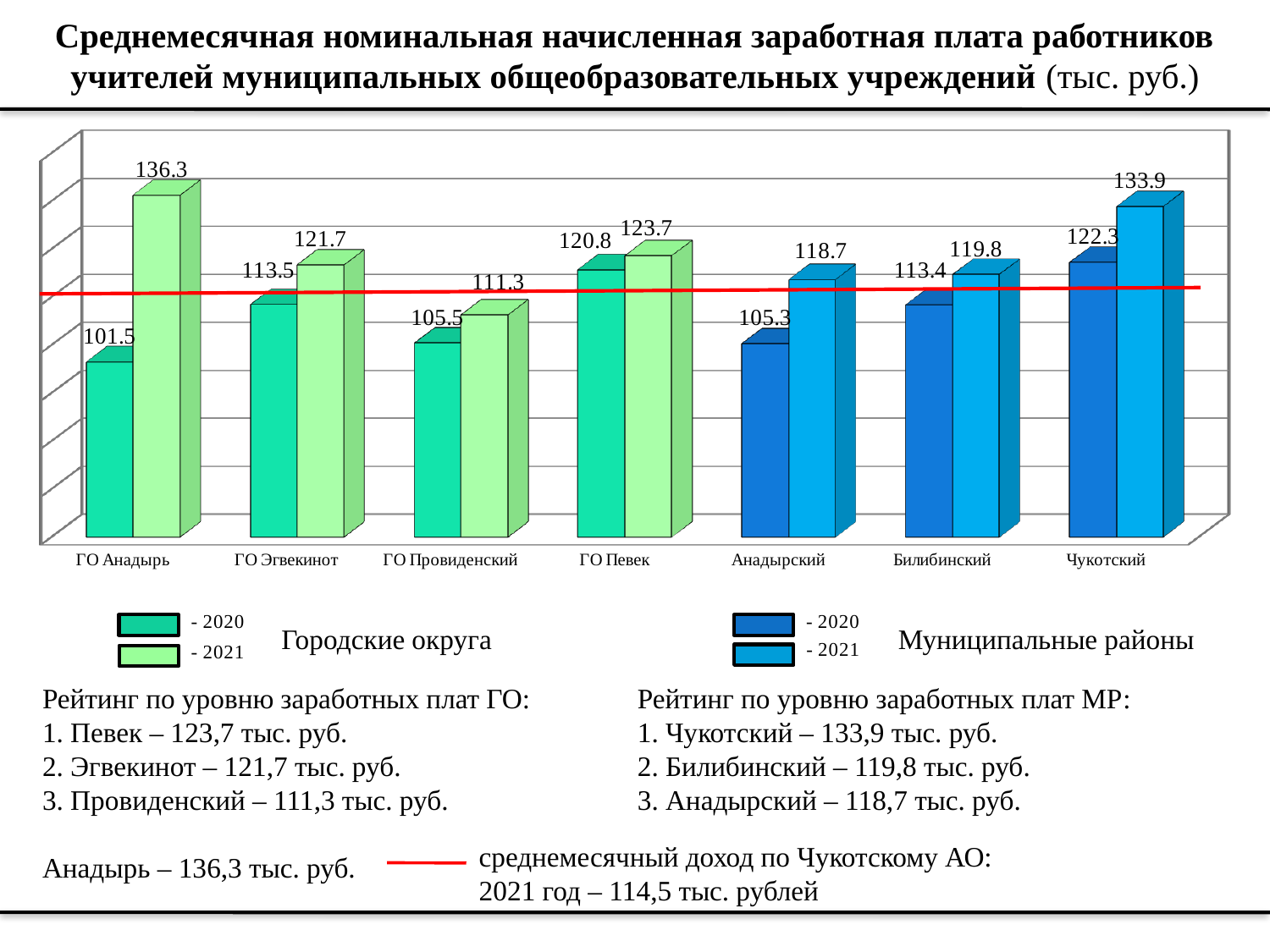
Which is larger: the 2020 value for ГО Певек or the 2020 value for Чукотский? Чукотский Which category has the highest 2021 value? ГО Анадырь What is the difference between the 2021 values for Чукотский and Билибинский? 14.1 What is the 2021 value for ГО Анадырь? 136.3 Which category has the lowest 2020 value? ГО Анадырь What is the 2020 value for Билибинский? 113.4 What value does the red horizontal line represent? 114,5 тыс. рублей What is the difference between the 2021 and 2020 values for ГО Анадырь? 34.8 What is the 2021 value for Анадырский? 118.7 How many categories are shown on the x axis? 7 What kind of chart is shown on the slide? bar chart How many series does the legend list for Городские округа? 2